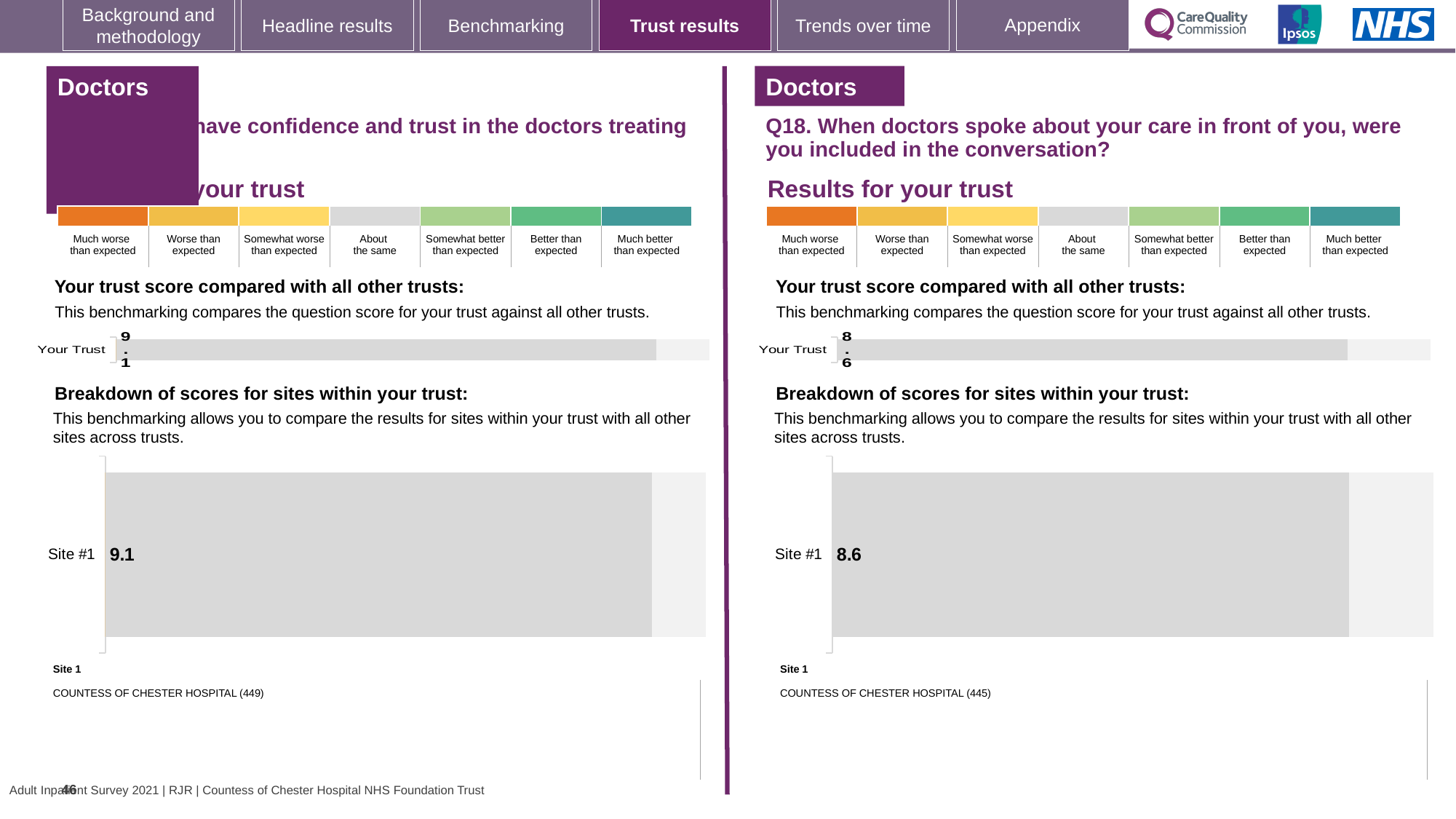
On the left half of the slide, what is the score shown for Your Trust in the 'Your trust score compared with all other trusts' chart? 9.1 On the right half of the slide (Q18), what is the score shown for Site #1 in the 'Breakdown of scores for sites within your trust' chart? 8.6 On the right half of the slide (Q18), what is the name of Site 1 listed below the site breakdown chart? COUNTESS OF CHESTER HOSPITAL (445) What kind of chart is used to show the Site #1 score on the left half of the slide? Bar chart On the right half of the slide (Q18), what is the score shown for Your Trust in the 'Your trust score compared with all other trusts' chart? 8.6 On the left half of the slide, what is the name of Site 1 listed below the site breakdown chart? COUNTESS OF CHESTER HOSPITAL (449) Is the Your Trust score for Q18 on the right half of the slide greater or less than 9? less Which is larger: the Your Trust score on the left half of the slide or the Your Trust score for Q18 on the right half? Left half (9.1) On the left half of the slide, what is the score shown for Site #1 in the 'Breakdown of scores for sites within your trust' chart? 9.1 Is the Site #1 score on the left half of the slide greater or less than 9? greater What is the difference between the Site #1 score on the left half of the slide and the Site #1 score for Q18 on the right half? 0.5 How many sites are shown in the 'Breakdown of scores for sites within your trust' chart on the right half of the slide (Q18)? 1